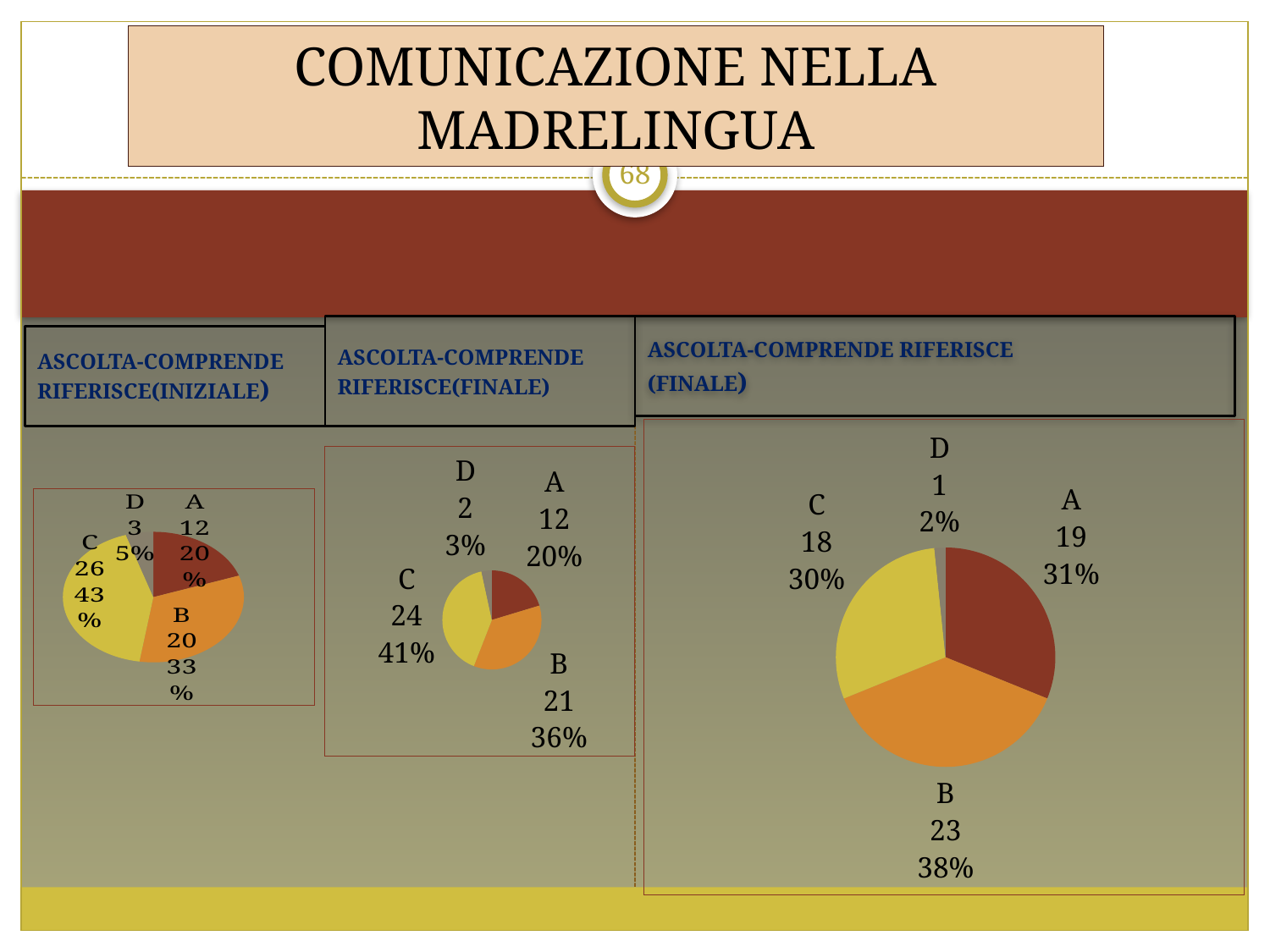
In the left pie chart (ASCOLTA-COMPRENDE RIFERISCE INIZIALE), what is the value for category C? 26 In the right pie chart (FINALE), is the value for B larger or smaller than the value for C? larger In the left pie chart (INIZIALE), what percentage share does category B have? 33% In the middle pie chart (FINALE), what is the value for category B? 21 What kind of chart is used on this slide? Pie chart In the left pie chart (INIZIALE), which category has the smallest slice? D In the right pie chart (FINALE), what is the value for category A? 19 How many categories does the right pie chart show? 4 In the right pie chart (FINALE), what percentage share does category D have? 2% In the middle pie chart (FINALE), which category has the largest slice? C In the right pie chart (FINALE), which category has the largest slice? B In the middle pie chart (FINALE), what is the difference between the values for C and A? 12